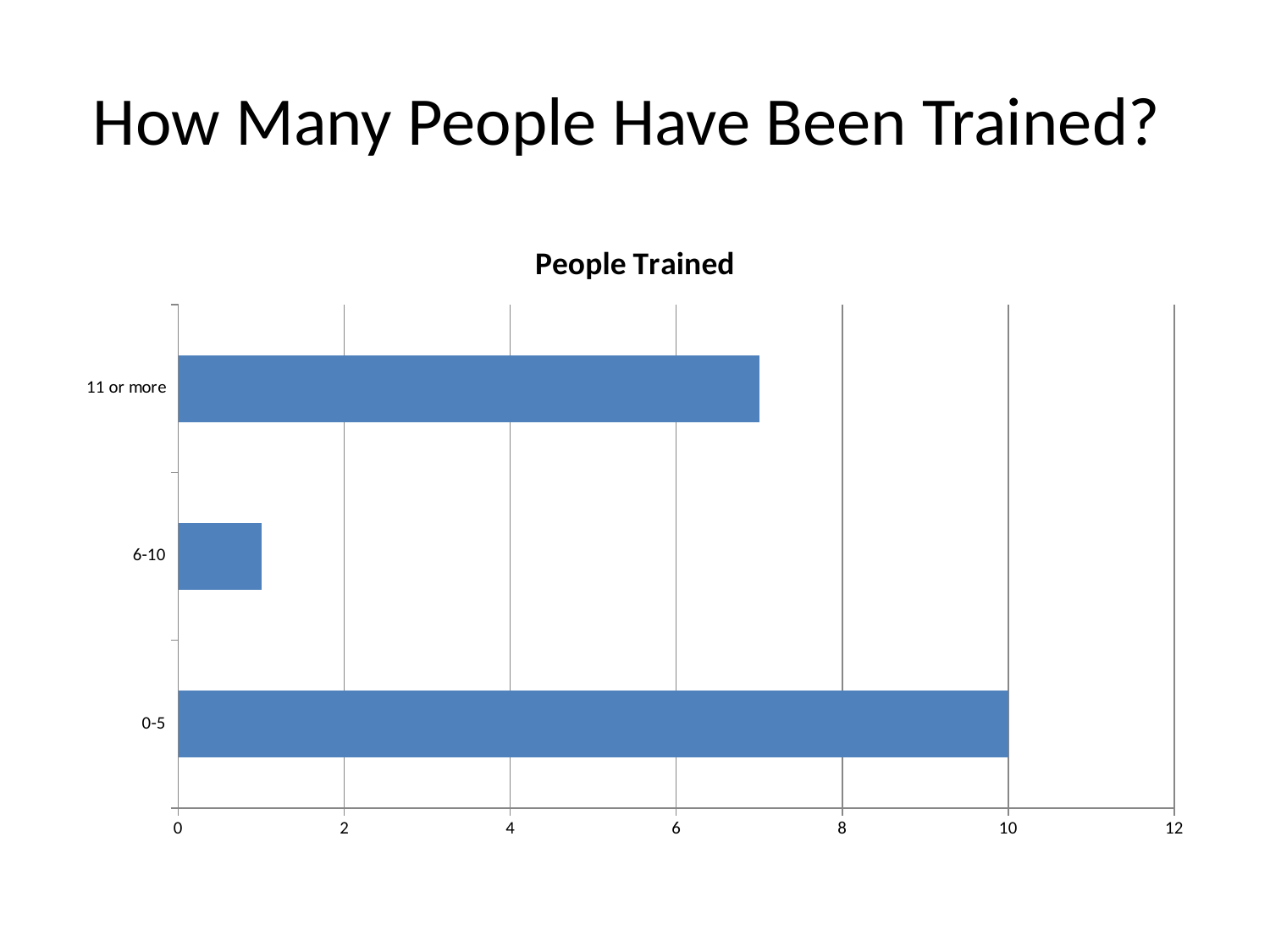
Is the value for 11 or more greater or less than 8? less Which category has the lowest value? 6-10 What is the value for the 0-5 category? 10 Which is larger, the value for 6-10 or the value for 11 or more? 11 or more What type of chart is shown on the slide? bar chart What is the maximum value shown on the horizontal axis? 12 Which category has the highest value? 0-5 How many categories are shown in the chart? 3 Is the value for 11 or more greater or less than 6? greater Is the value for 6-10 greater or less than 2? less What is the title of the chart? People Trained Which is larger, the value for 0-5 or the value for 11 or more? 0-5